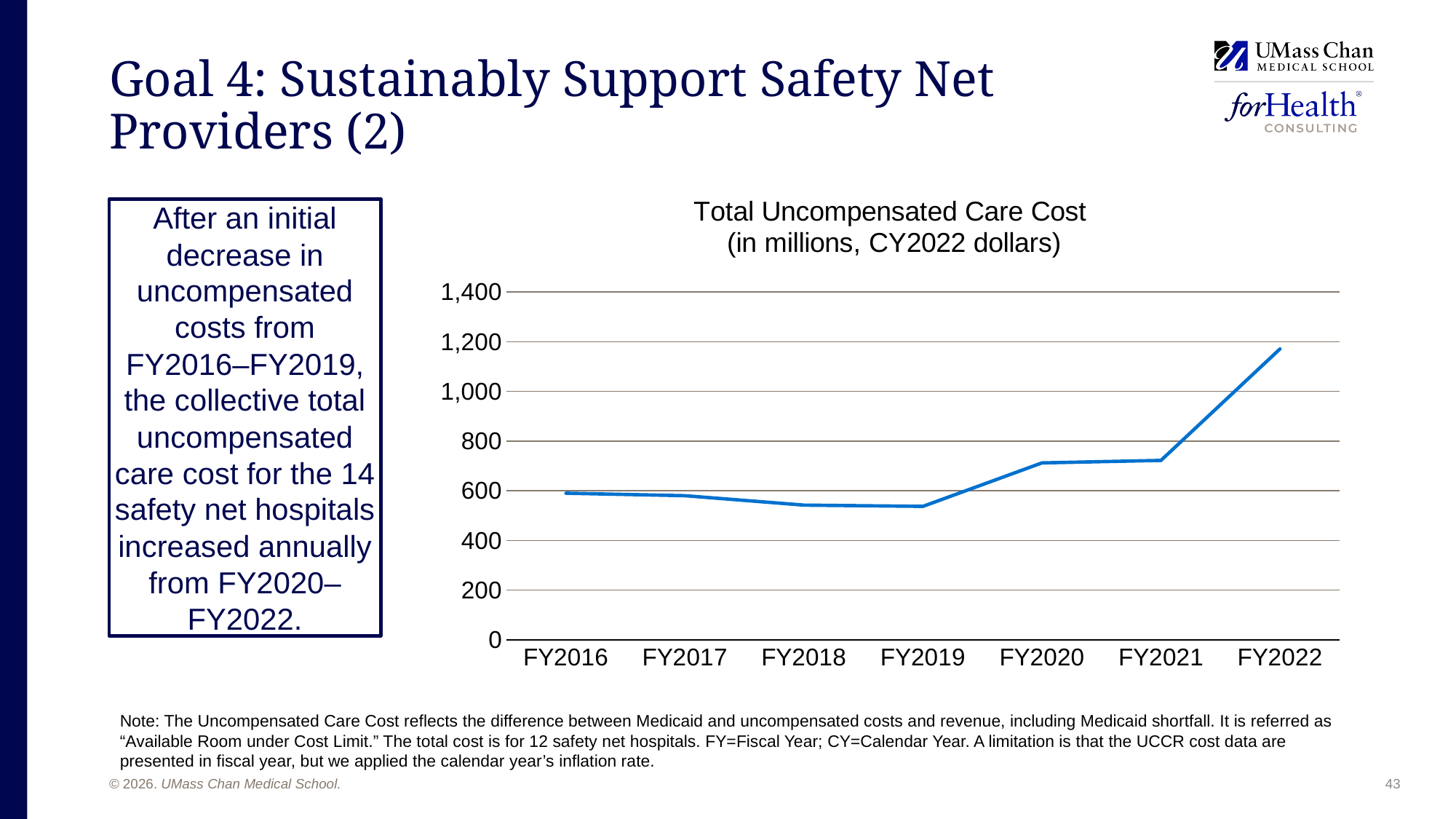
Is the value for FY2020 greater or less than 600? greater Which is larger, the value for FY2020 or the value for FY2019? FY2020 Is the value for FY2019 greater or less than 600? less Is the value for FY2021 greater or less than 800? less Do the values rise or fall from FY2016 to FY2019? fall In what units are the values in the chart expressed, according to the chart title? in millions, CY2022 dollars How many fiscal years are plotted on the x axis of the chart? 7 Do the values rise or fall from FY2019 to FY2022? rise Which fiscal year has the highest Total Uncompensated Care Cost? FY2022 What kind of chart is shown on the slide? line chart